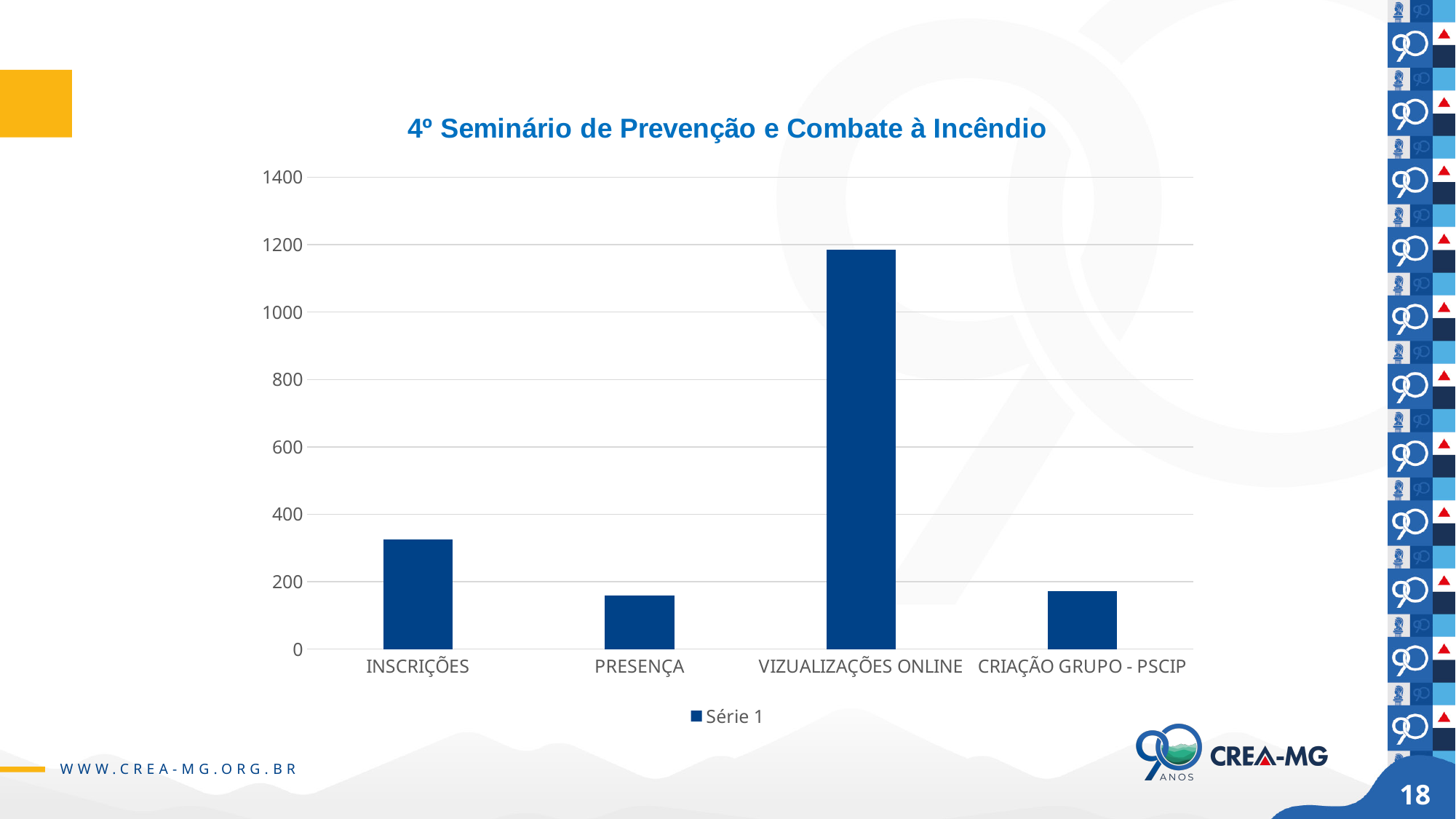
How many series does the chart legend list? 1 What kind of chart is shown on the slide? bar chart How many categories are shown on the x axis of the chart? 4 What is the title of the chart? 4º Seminário de Prevenção e Combate à Incêndio What is the name of the series shown in the legend? Série 1 Is the value for PRESENÇA greater or less than 200? less Is the value for CRIAÇÃO GRUPO - PSCIP greater or less than 200? less Is the value for INSCRIÇÕES greater or less than 200? greater Which category has the highest value? VIZUALIZAÇÕES ONLINE Which is larger, the value for INSCRIÇÕES or the value for PRESENÇA? INSCRIÇÕES